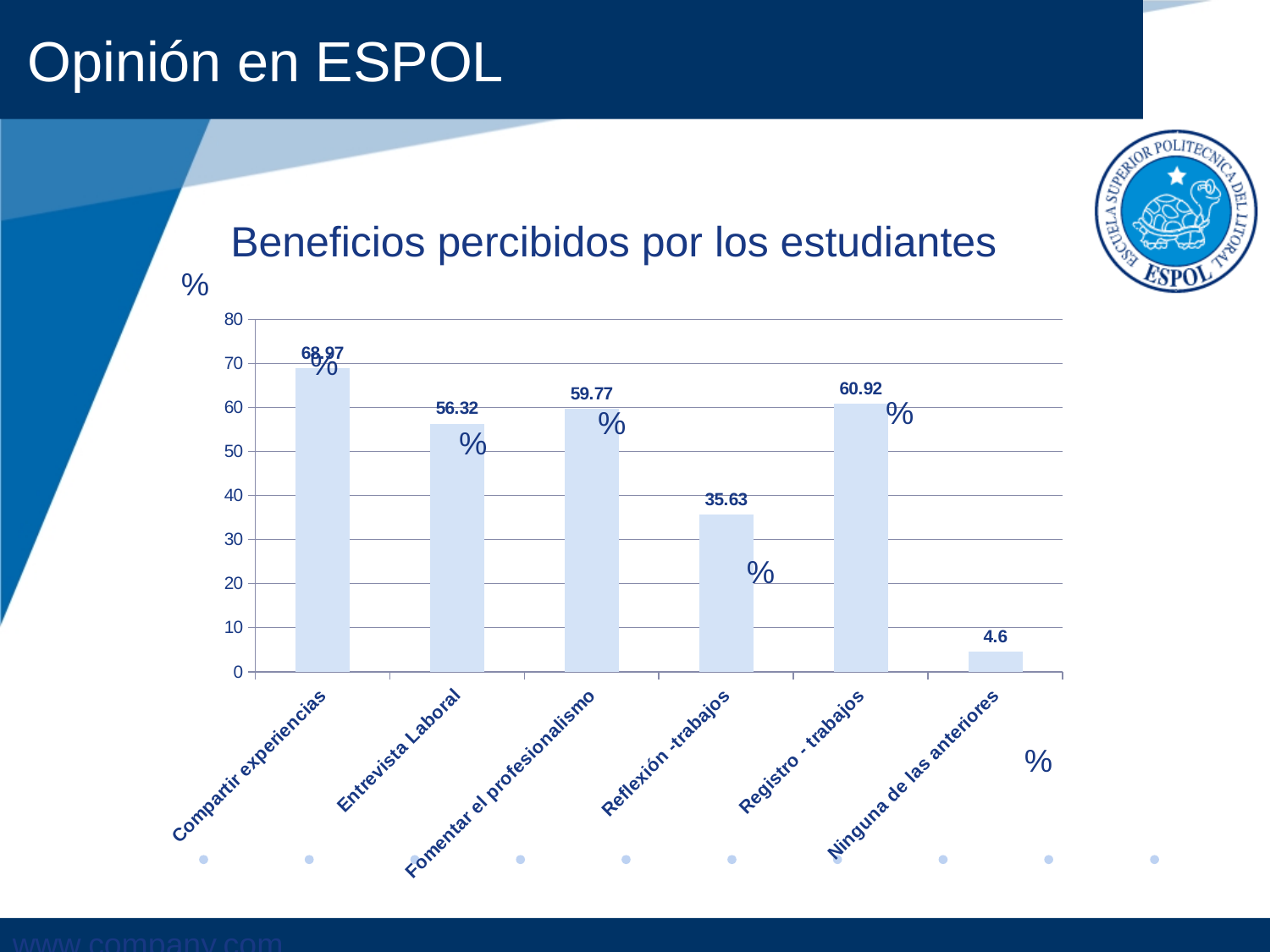
What is the value for Reflexión -trabajos? 35.63 What is the difference between Registro - trabajos and Fomentar el profesionalismo? 1.15 What is the value for Compartir experiencias? 68.97 What kind of chart is shown on the slide? bar chart What is the title of the chart? Beneficios percibidos por los estudiantes Which category has the highest value? Compartir experiencias How many categories are shown in the chart? 6 What is the value for Ninguna de las anteriores? 4.6 What is the value for Entrevista Laboral? 56.32 Which category has the lowest value? Ninguna de las anteriores Is the value for Reflexión -trabajos greater or less than 40? less Which is larger, Entrevista Laboral or Fomentar el profesionalismo? Fomentar el profesionalismo